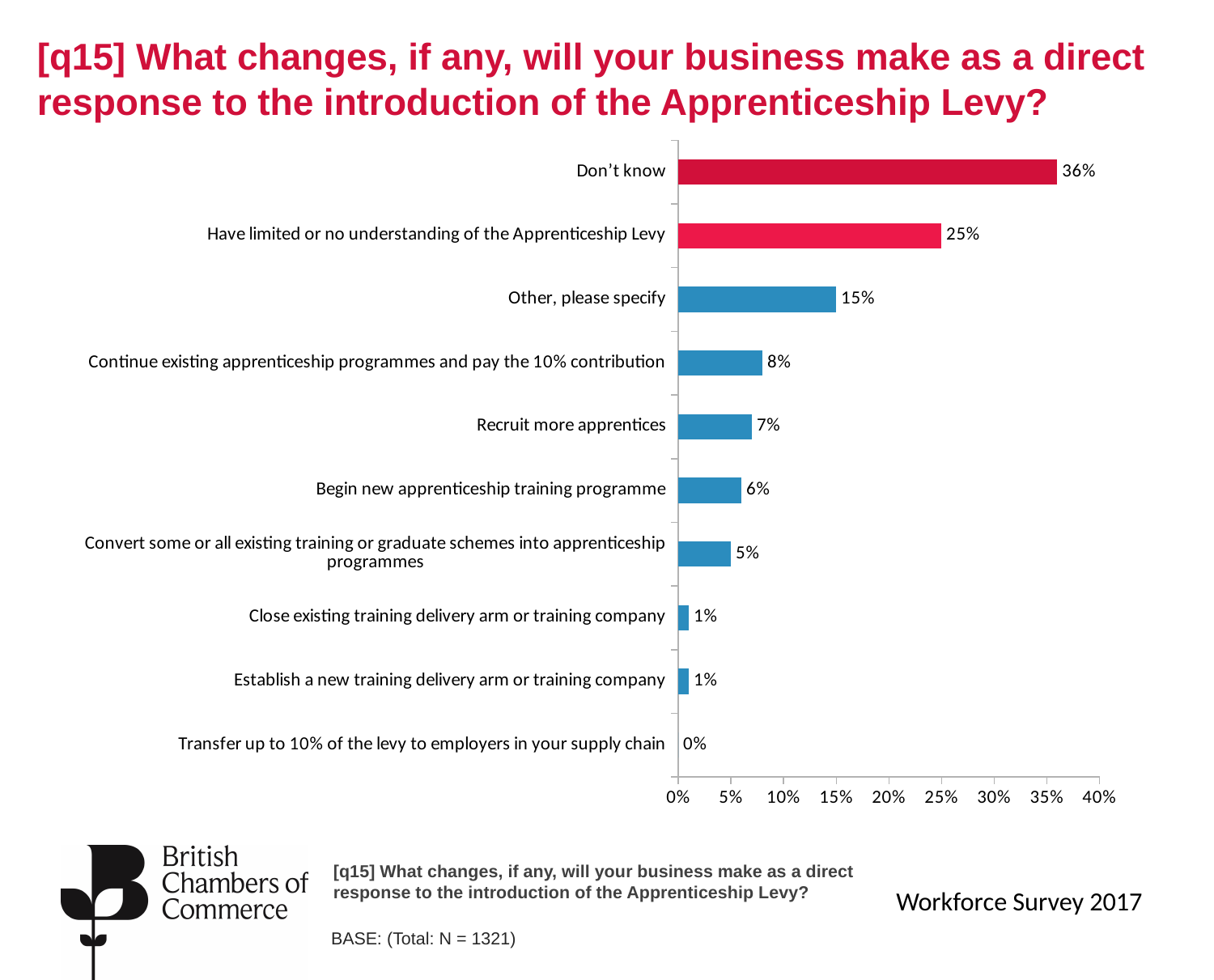
What percentage of respondents answered "Don't know"? 36% Which category has the lowest value? Transfer up to 10% of the levy to employers in your supply chain What is the value for "Recruit more apprentices"? 7% What is the value for "Convert some or all existing training or graduate schemes into apprenticeship programmes"? 5% What is the difference between "Don't know" and "Have limited or no understanding of the Apprenticeship Levy"? 11% Is the value for "Have limited or no understanding of the Apprenticeship Levy" greater or less than 20%? greater Which is larger: "Other, please specify" or "Begin new apprenticeship training programme"? Other, please specify Which category has the highest value? Don't know What kind of chart is shown on the slide? Bar chart What is the base size (N) stated on the slide? 1321 How many categories are shown in the chart? 10 What is the value for "Continue existing apprenticeship programmes and pay the 10% contribution"? 8%